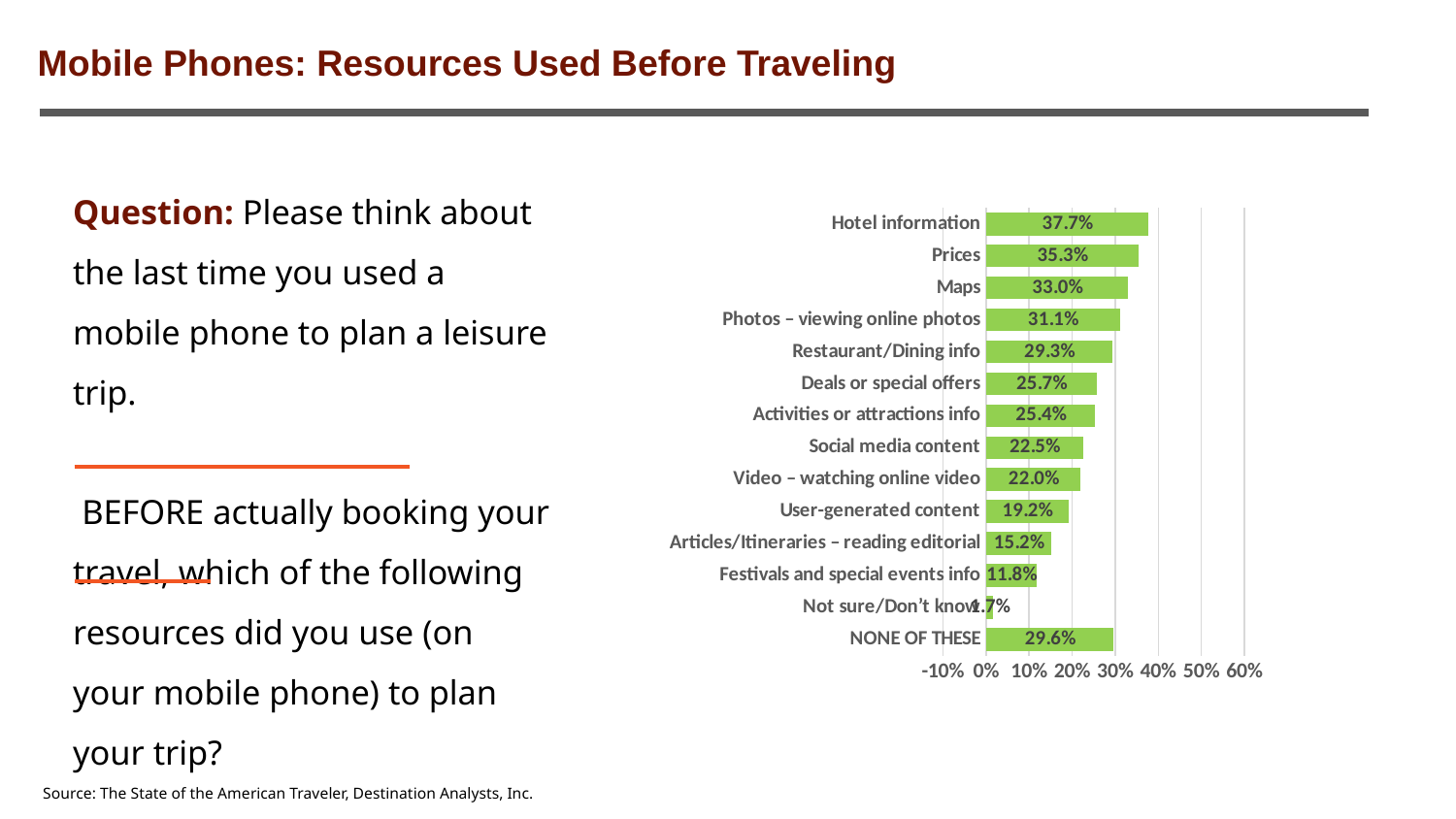
What is the title of the slide containing the chart? Mobile Phones: Resources Used Before Traveling What is the difference between the values for Prices and Maps? 2.3% Which is larger, the value for Social media content or the value for User-generated content? Social media content Which resource has the highest percentage in the chart? Hotel information What percentage of respondents used hotel information on their mobile phone before booking? 37.7% Is the value for Restaurant/Dining info greater or less than 20%? greater What is the value shown for Maps? 33.0% Which category has the lowest value in the chart? Not sure/Don't know What type of chart is shown on the slide? Bar chart How many categories are shown in the chart? 14 What percentage is shown for NONE OF THESE? 29.6% What is the value for Festivals and special events info? 11.8%